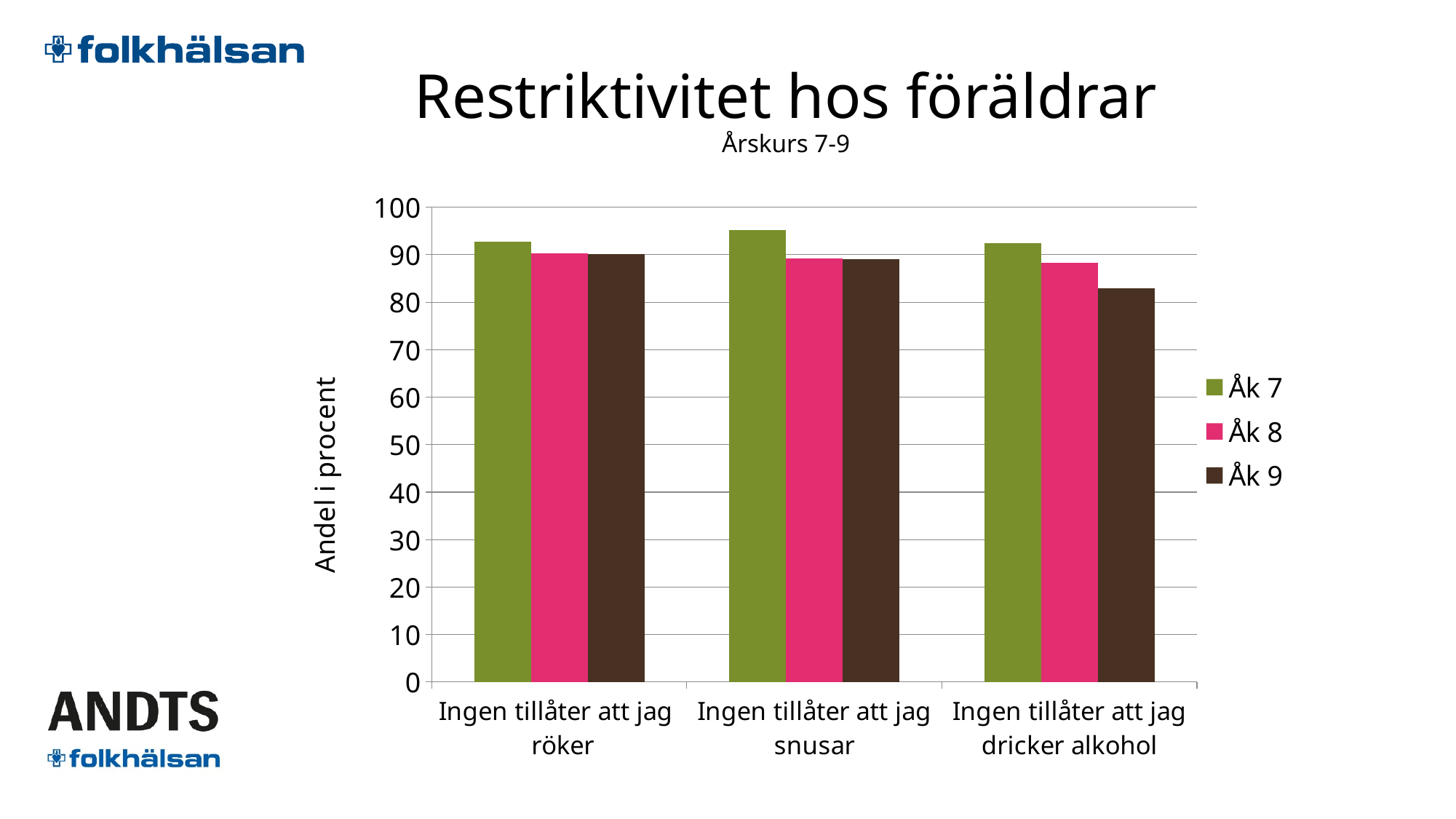
Is the value for Åk 8 in 'Ingen tillåter att jag dricker alkohol' greater or less than 90? less What kind of chart is shown on the slide? bar chart How many categories are shown on the x axis? 3 Which series are listed in the legend? Åk 7, Åk 8, Åk 9 For the Åk 9 series, which category has the lowest value? Ingen tillåter att jag dricker alkohol Is the value for Åk 9 in 'Ingen tillåter att jag dricker alkohol' greater or less than 80? greater For 'Ingen tillåter att jag dricker alkohol', which is larger, Åk 7 or Åk 9? Åk 7 Is the value for Åk 7 in 'Ingen tillåter att jag snusar' greater or less than 90? greater For the Åk 7 series, which category has the highest value? Ingen tillåter att jag snusar What is the label of the vertical axis? Andel i procent How many series does the legend list? 3